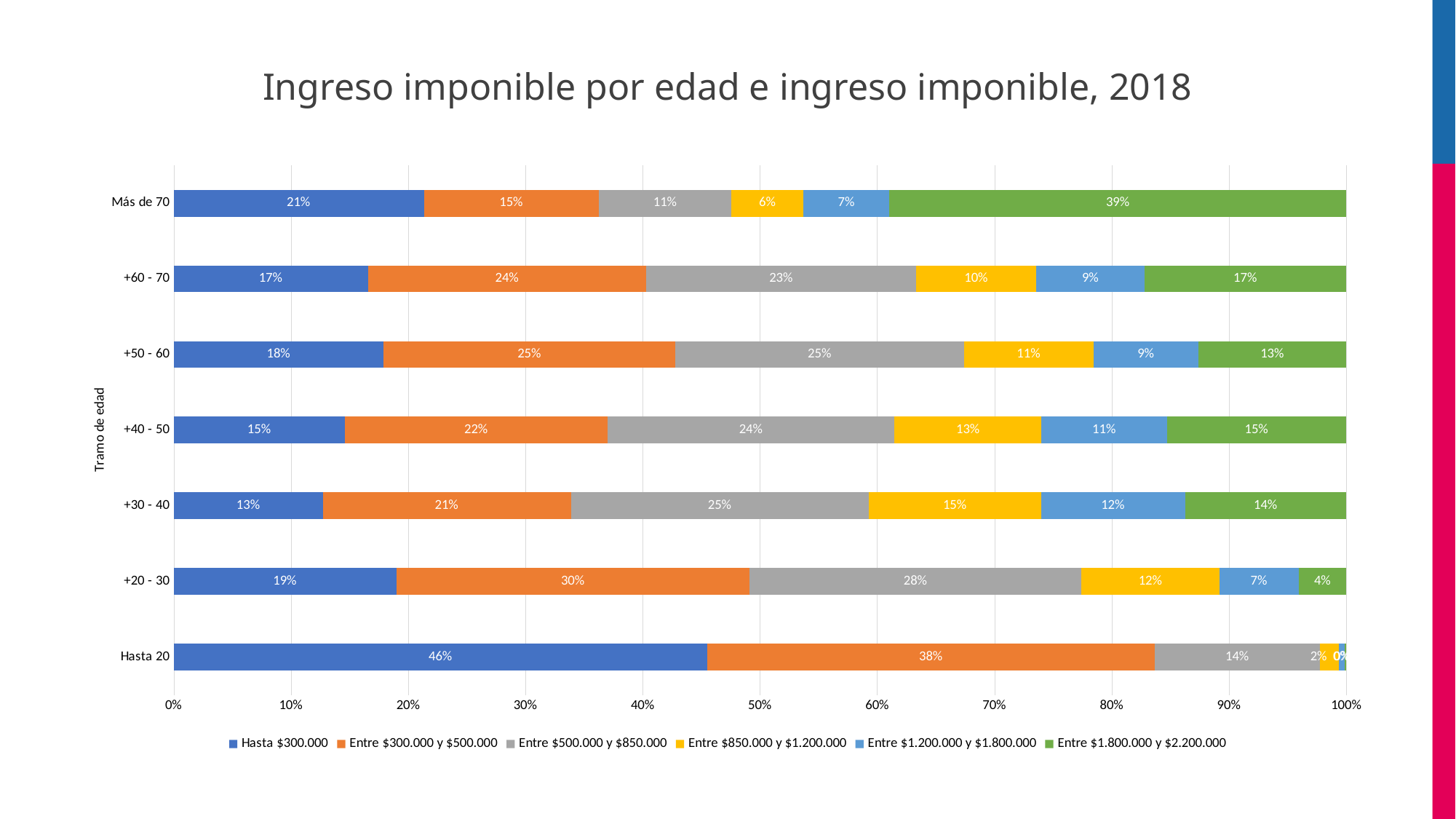
Which is larger: the 'Entre $850.000 y $1.200.000' value for '+30 - 40' or for '+60 - 70'? +30 - 40 What kind of chart is shown on the slide? Stacked bar chart How many age groups (Tramo de edad) are shown on the chart? 7 Which age group has the lowest value for 'Entre $1.800.000 y $2.200.000'? Hasta 20 What is the value of 'Entre $300.000 y $500.000' for the '+20 - 30' age group? 30% What is the value of 'Hasta $300.000' for the 'Hasta 20' age group? 46% How many series does the legend list? 6 Which age group has the highest value for 'Hasta $300.000'? Hasta 20 What is the title of the chart? Ingreso imponible por edad e ingreso imponible, 2018 What is the value of 'Entre $1.800.000 y $2.200.000' for the 'Más de 70' age group? 39% What is the difference between the 'Entre $500.000 y $850.000' values for '+20 - 30' and 'Más de 70'? 17% What is the value of 'Entre $1.200.000 y $1.800.000' for the '+40 - 50' age group? 11%